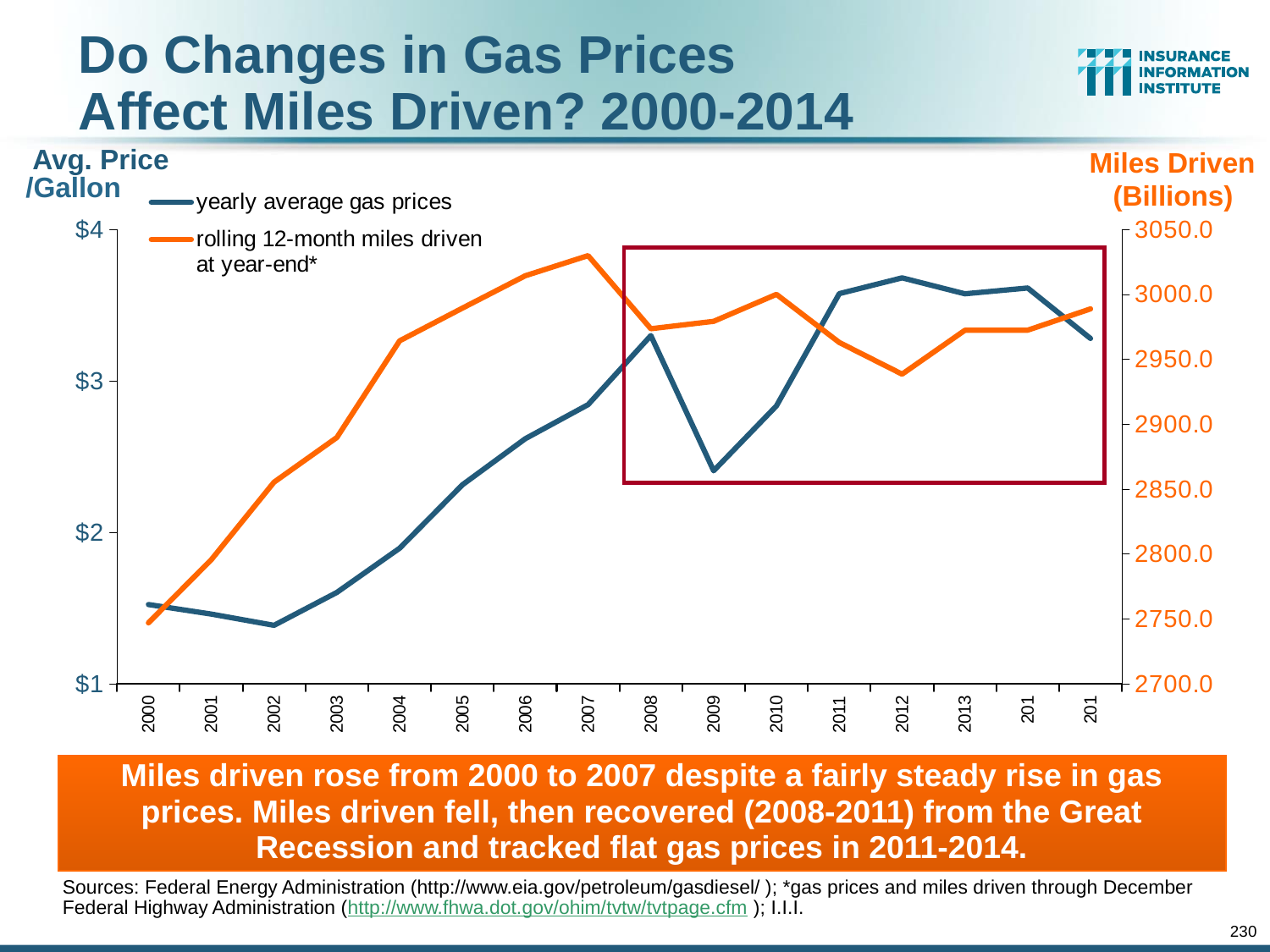
Which colour is used for the rolling 12-month miles driven line? orange How many series does the legend list? 2 Is the yearly average gas price for 2002 greater or less than $2? less Is the rolling 12-month miles driven value for 2007 greater or less than 3000.0? greater Is the yearly average gas price for 2012 greater or less than $3? greater In which year was rolling 12-month miles driven at year-end highest? 2007 Did yearly average gas prices rise or fall from 2002 to 2008? rise Which year had the higher yearly average gas price, 2008 or 2009? 2008 What kind of chart is shown on the slide? line chart In which year was rolling 12-month miles driven at year-end lowest? 2000